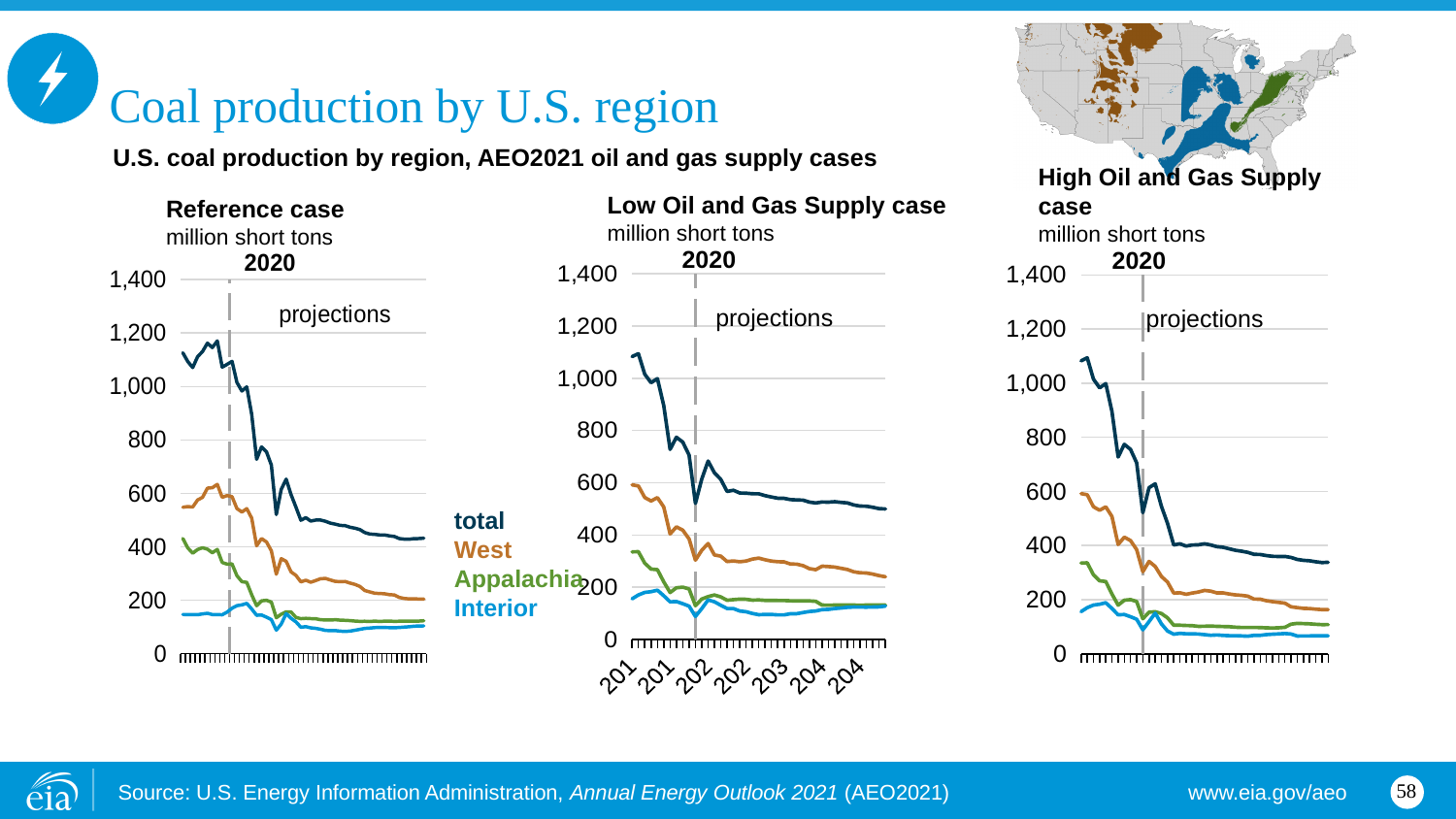
What unit is used on the y axis of the three charts? million short tons In the Reference case chart, is the value for total at the end of the projection period greater or less than 400? greater In the Low Oil and Gas Supply case chart, is the value for total at the end of the projection period greater or less than 600? less How many series does the legend list for the coal production charts? 4 What year does the vertical dashed line in each chart mark as the start of projections? 2020 In the Reference case chart, which series has the highest values? total In the High Oil and Gas Supply case chart, is the value for total at the end of the projection period greater or less than 400? less In the Reference case chart, which is larger at the end of the projection period, West or Appalachia? West In the High Oil and Gas Supply case chart, which series has the lowest value at the end of the projection period? Interior In the Reference case chart, does the total coal production rise or fall over the projection period? fall What kind of chart is the Reference case chart? line chart